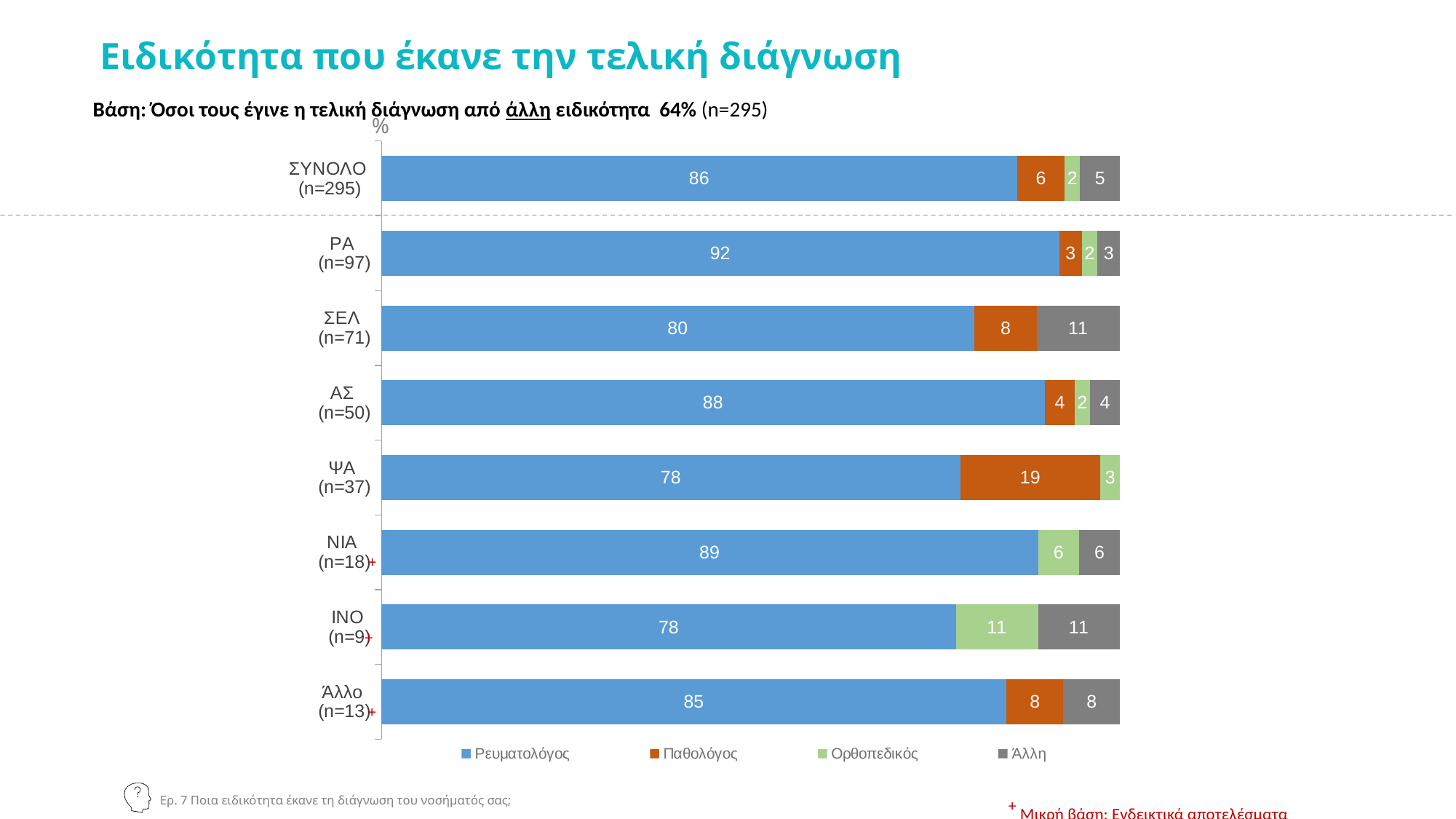
What is the value for Ορθοπεδικός in the ΙΝΟ (n=9) category? 11 Which category has the highest value for Ρευματολόγος? ΡΑ (n=97) What is the value for Άλλη in the ΣΕΛ (n=71) category? 11 Which is larger: the Ρευματολόγος value for ΑΣ (n=50) or for ΣΥΝΟΛΟ (n=295)? ΑΣ (n=50) How many series does the legend list? 4 What is the value for Ρευματολόγος in the ΡΑ (n=97) category? 92 What is the value for Παθολόγος in the ΨΑ (n=37) category? 19 How many categories (rows) are plotted in the chart? 8 What type of chart is shown on the slide? stacked bar chart What is the difference between the Ρευματολόγος values for ΡΑ (n=97) and ΣΕΛ (n=71)? 12 What is the total of the stacked bar for ΣΥΝΟΛΟ (n=295)? 99 Which category has the highest value for Παθολόγος? ΨΑ (n=37)